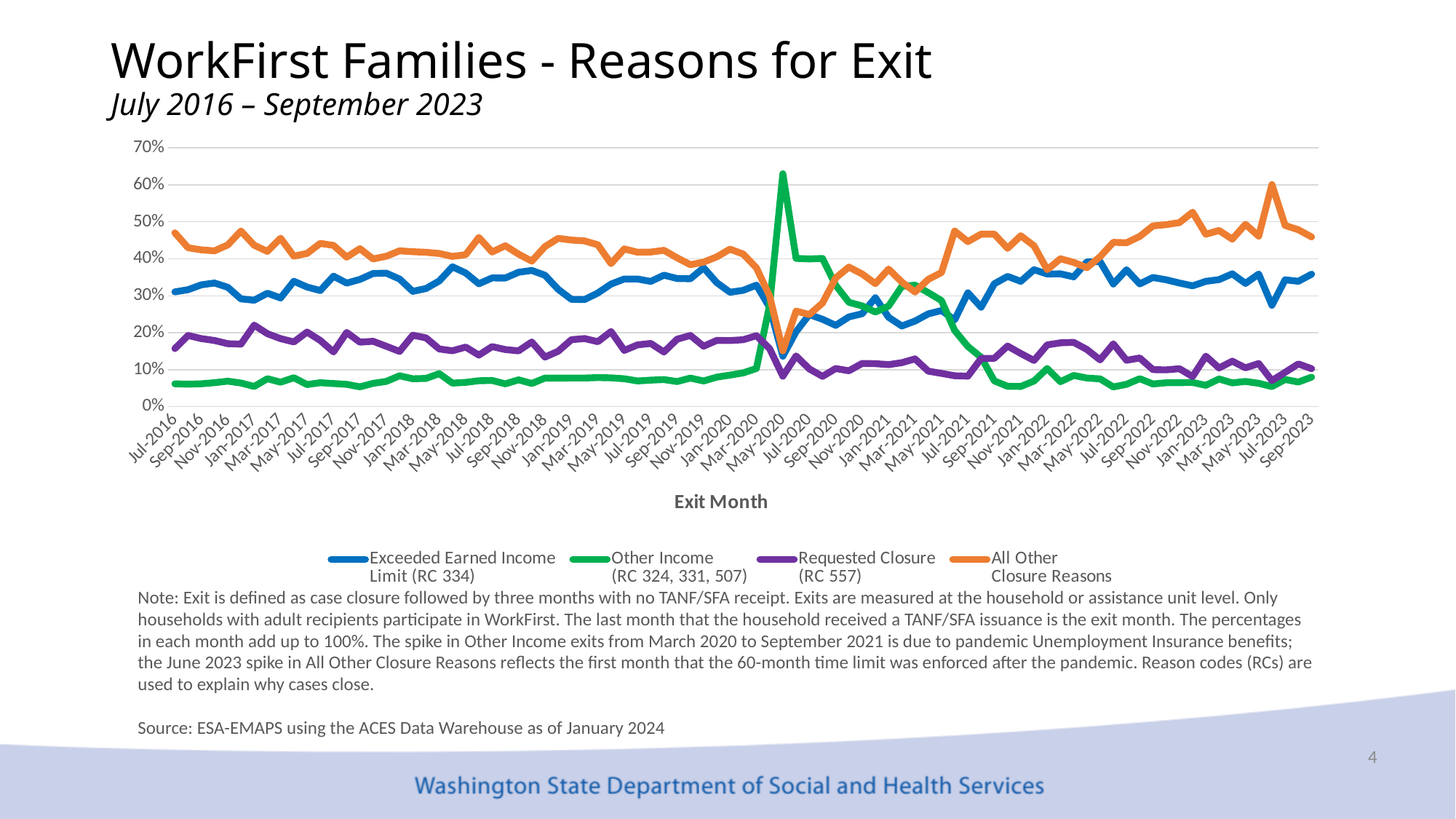
What kind of chart is shown on the slide? Line chart Is the highest value reached by the All Other Closure Reasons line greater or less than 50%? greater In Jul-2016, which is higher: Exceeded Earned Income Limit or Requested Closure? Exceeded Earned Income Limit Does the Other Income line rise or fall between May-2020 and Sep-2021? Fall Which series reaches the highest value anywhere on the chart? Other Income Is the value for Other Income in May-2020 greater or less than 60%? greater Is the value for Other Income in Jul-2016 greater or less than 10%? less What are the four series named in the legend? Exceeded Earned Income Limit (RC 334), Other Income (RC 324, 331, 507), Requested Closure (RC 557), All Other Closure Reasons What is the title of the x axis? Exit Month In Sep-2023, which is higher: All Other Closure Reasons or Exceeded Earned Income Limit? All Other Closure Reasons How many series does the legend list? 4